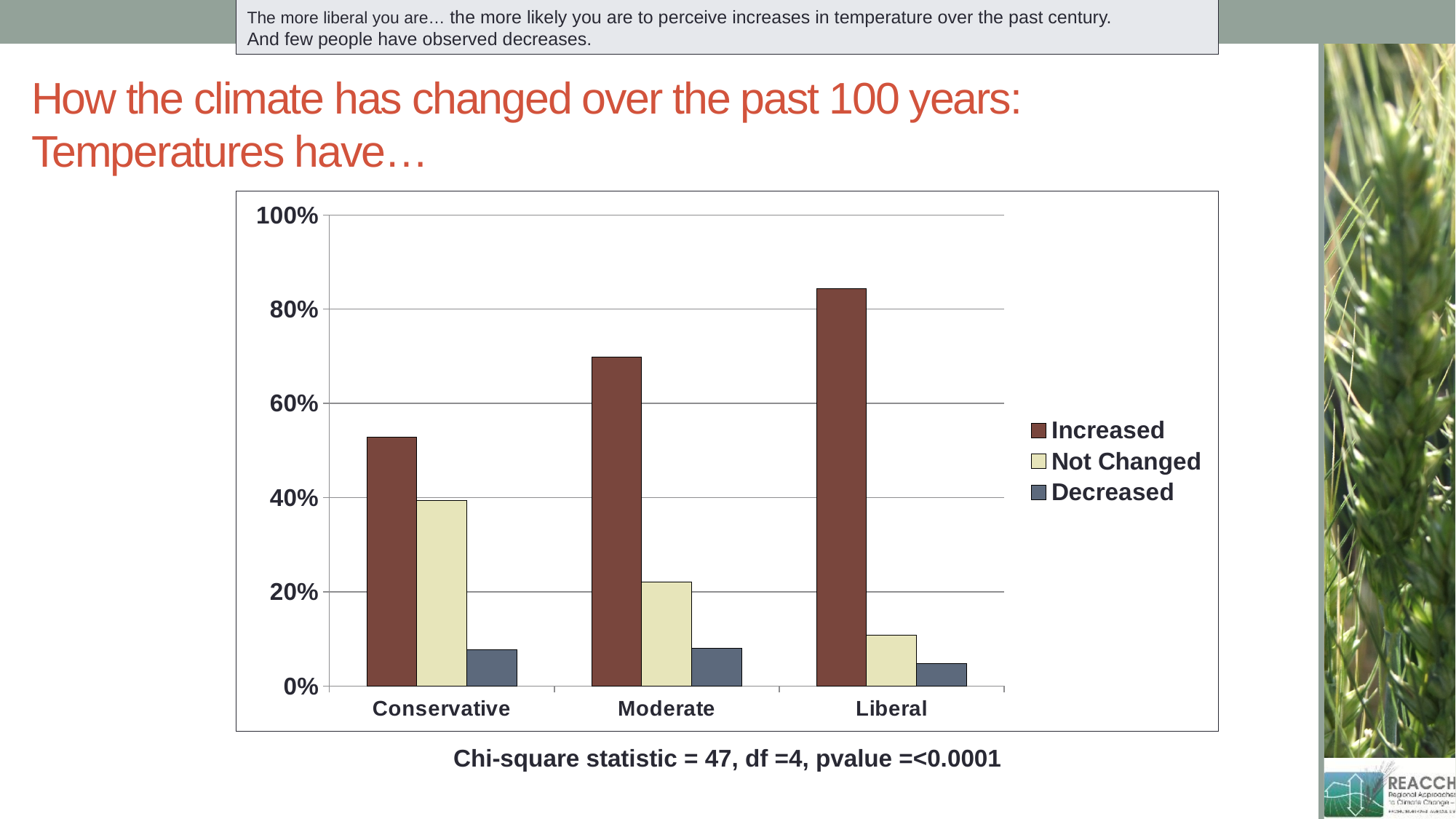
Which category has the lowest value for the Not Changed series? Liberal How many categories are shown on the x axis? 3 Which category has the highest value for the Increased series? Liberal Is the Increased value for Liberal greater or less than 80%? greater Which series is shown in dark red in the legend? Increased Is the Increased value for Conservative greater or less than 60%? less Is the Not Changed value for Moderate greater or less than 20%? greater How many series does the legend list? 3 What kind of chart is shown on the slide? bar chart Does the Increased series rise or fall moving from Conservative to Liberal along the x axis? rise Which is larger for Conservative: the Increased value or the Not Changed value? Increased